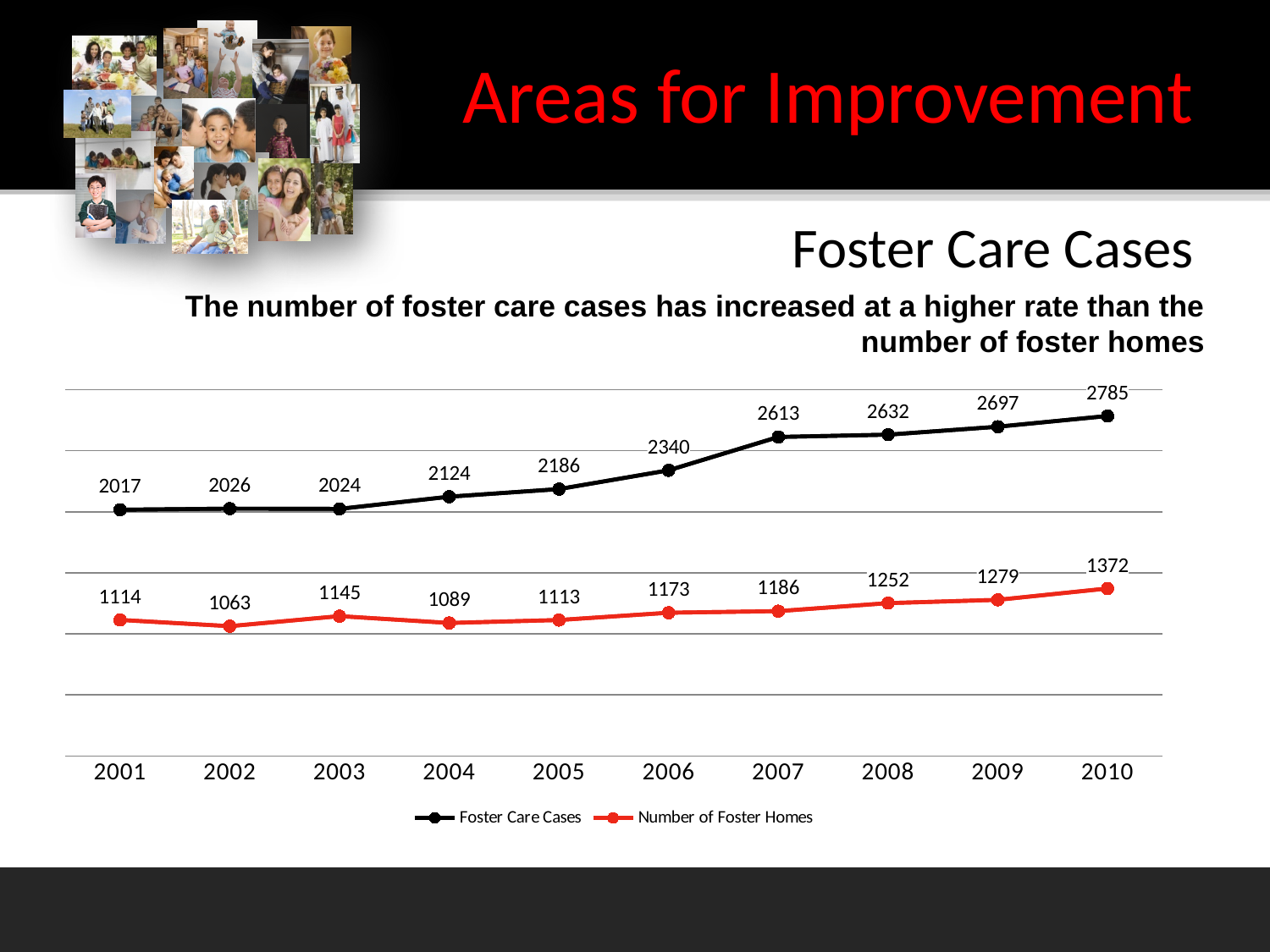
In which year is the Number of Foster Homes lowest? 2002 How many years are plotted along the x axis? 10 What type of chart is shown on the slide? line chart How many series does the legend list? 2 Which is larger in 2005: Foster Care Cases or Number of Foster Homes? Foster Care Cases What is the difference between Foster Care Cases and Number of Foster Homes in 2010? 1413 What is the number of Foster Care Cases in 2007? 2613 By how much did the number of Foster Care Cases increase from 2001 to 2010? 768 What is the Number of Foster Homes in 2004? 1089 Do the Foster Care Cases values generally rise or fall from 2001 to 2010? rise In which year is the number of Foster Care Cases highest? 2010 What colour is the line for Number of Foster Homes? red